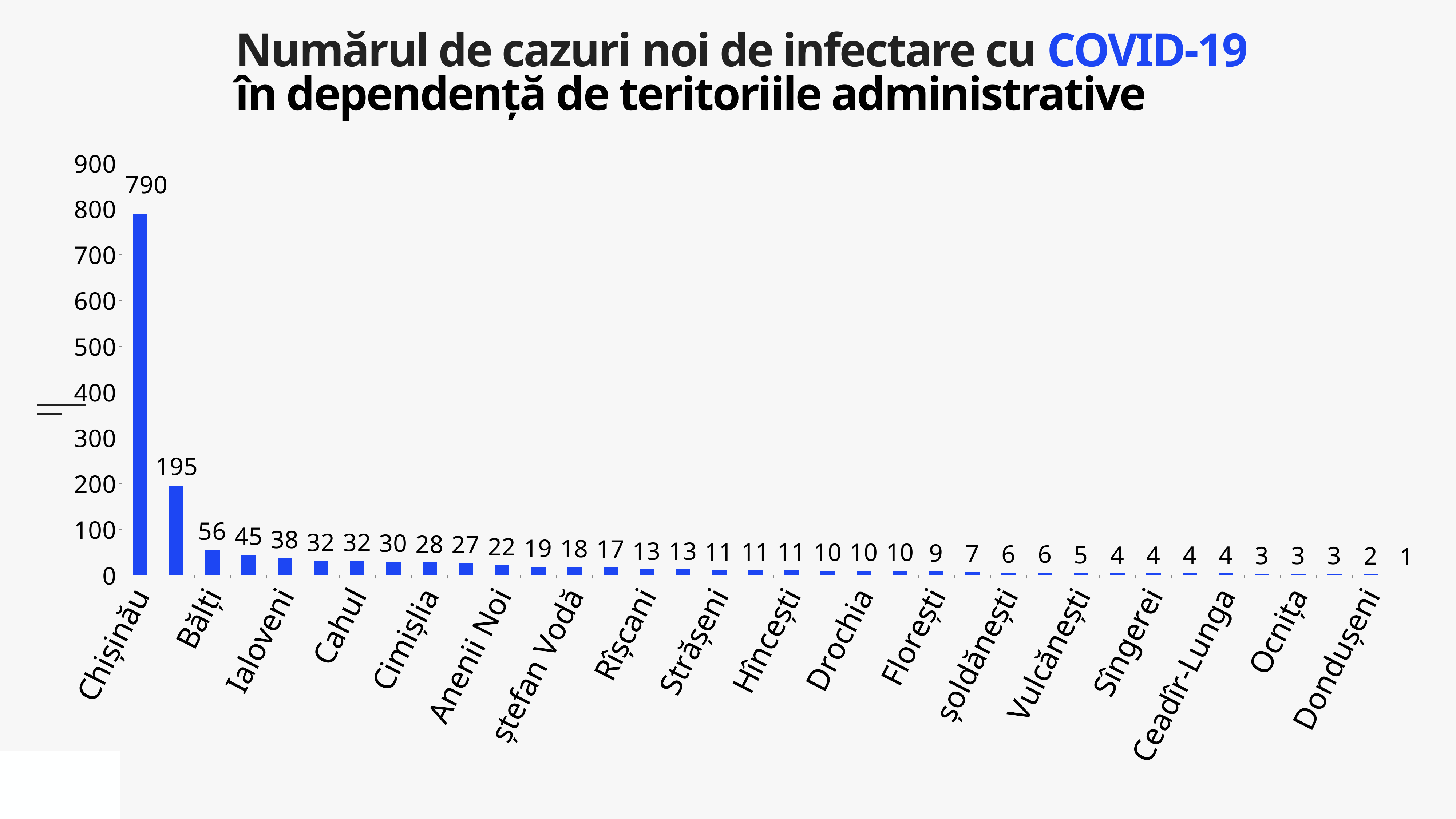
What is the value of the second-tallest bar in the chart? 195 What is the value of the tallest bar in the chart? 790 What is the value of the smallest bar in the chart? 1 Do the bar values rise or fall from left to right along the x axis? fall What kind of chart is shown on the slide? bar chart Which has more new cases, Chișinău or Bălți? Chișinău What is the highest tick value shown on the vertical axis? 900 Is the value for Chișinău greater or less than 700? greater How many new COVID-19 cases are shown for Chișinău? 790 What is the difference between the two tallest bars (790 and 195)? 595 What colour are the bars in the chart? blue Which territory has the highest number of new COVID-19 cases? Chișinău